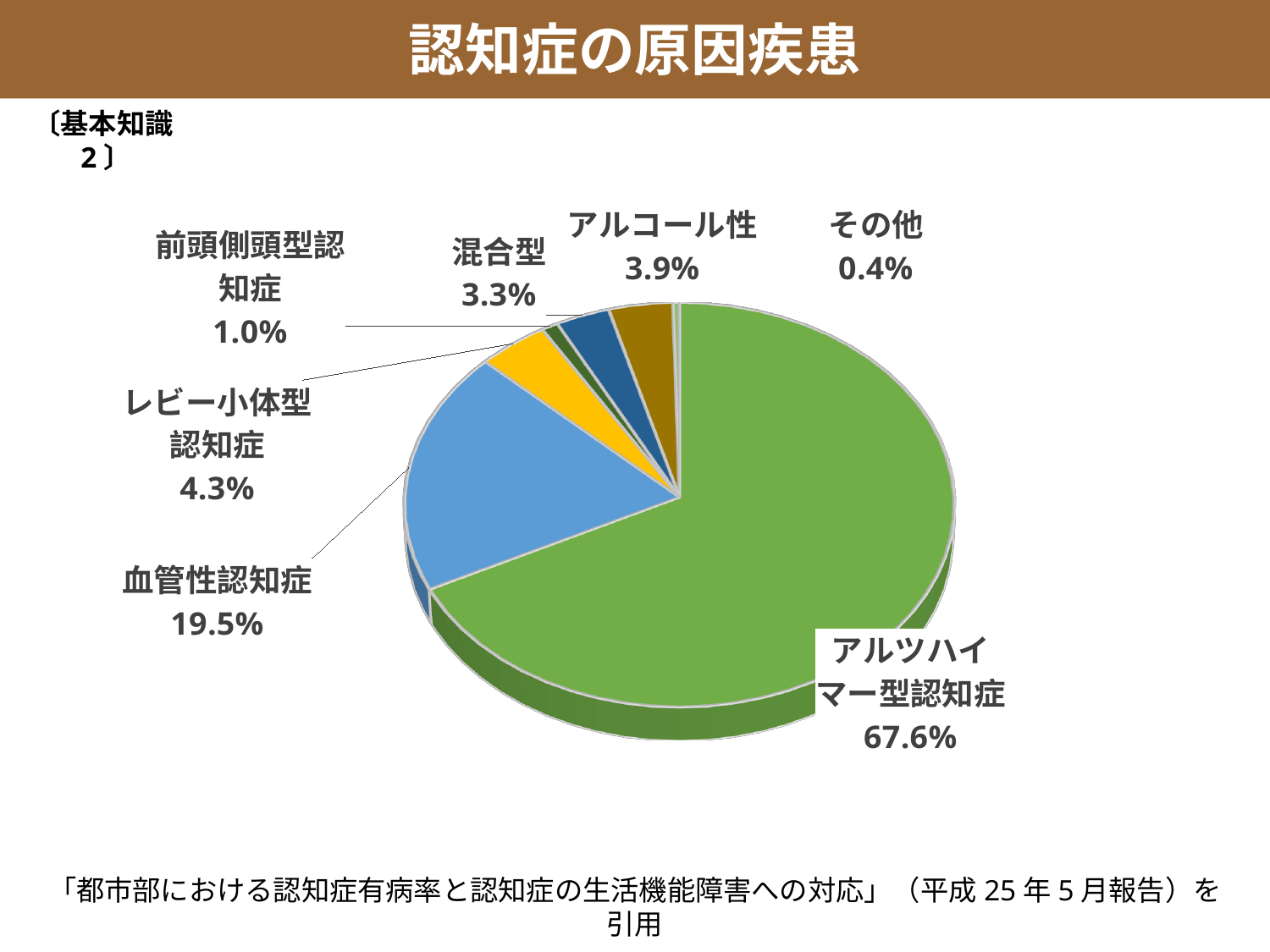
What is the difference in percentage points between アルツハイマー型認知症 and 血管性認知症? 48.1 What percentage does the pie chart show for アルコール性? 3.9% What percentage does the pie chart show for 血管性認知症? 19.5% What kind of chart is shown on the slide? pie chart What percentage does the pie chart show for 混合型? 3.3% What percentage does the pie chart show for レビー小体型認知症? 4.3% What is the title of the slide containing the pie chart? 認知症の原因疾患 Which is larger, the share for アルコール性 or the share for 混合型? アルコール性 Which category has the largest slice of the pie chart? アルツハイマー型認知症 How many categories are shown in the pie chart? 7 What percentage does the pie chart show for アルツハイマー型認知症? 67.6% Which category has the smallest slice of the pie chart? その他